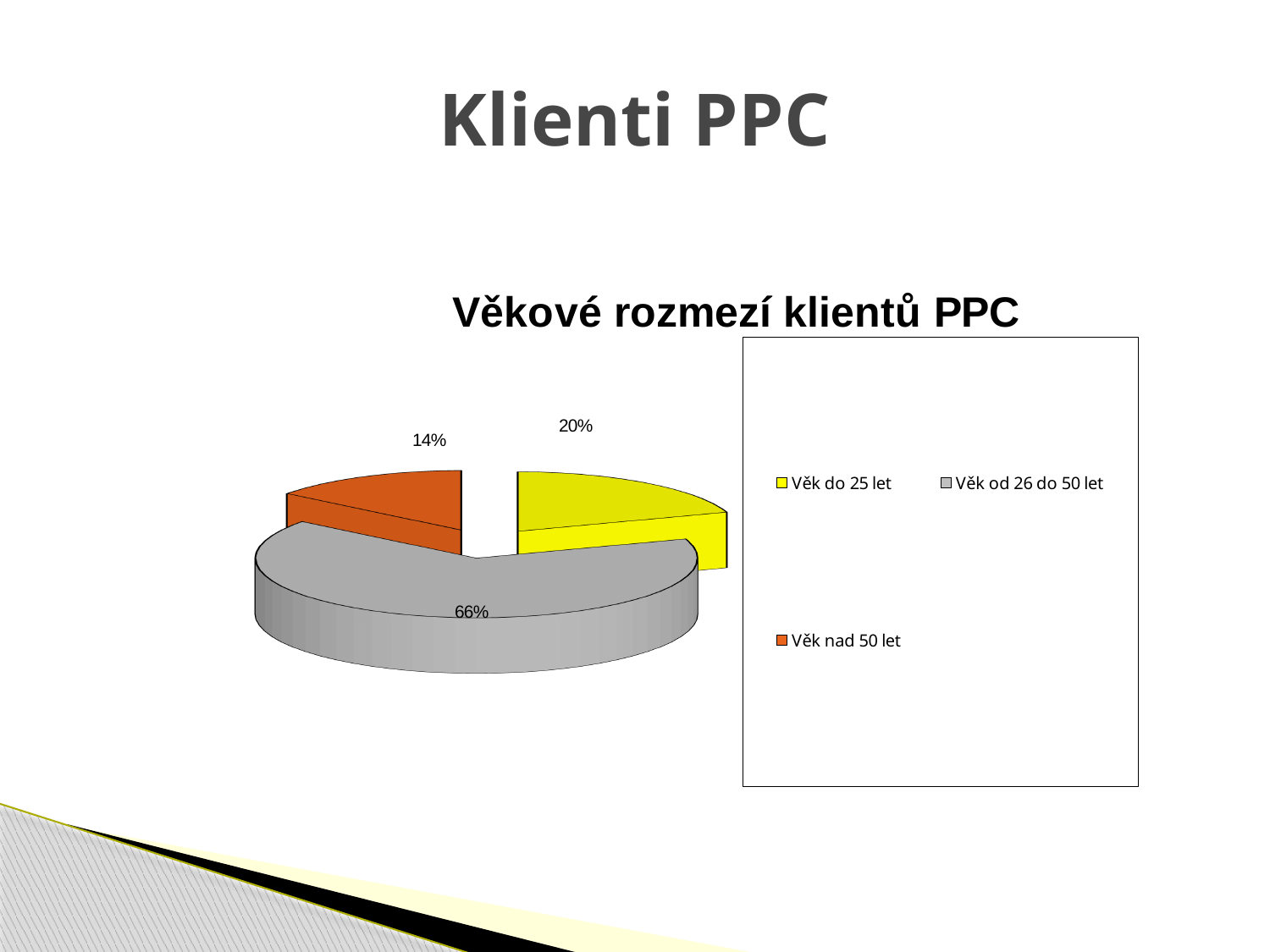
What kind of chart is shown on the slide? Pie chart What is the title of the chart? Věkové rozmezí klientů PPC Which is larger, the share for "Věk do 25 let" or for "Věk nad 50 let"? Věk do 25 let Which age group has the largest share of the pie? Věk od 26 do 50 let What share of the pie does "Věk do 25 let" have? 20% Which colour represents "Věk nad 50 let" in the chart? Orange Which age group has the smallest share of the pie? Věk nad 50 let What share of the pie does "Věk od 26 do 50 let" have? 66% What is the difference between the shares of "Věk od 26 do 50 let" and "Věk do 25 let"? 46% What share of the pie does "Věk nad 50 let" have? 14% How many slices does the pie chart have? 3 What is the difference between the shares of "Věk do 25 let" and "Věk nad 50 let"? 6%